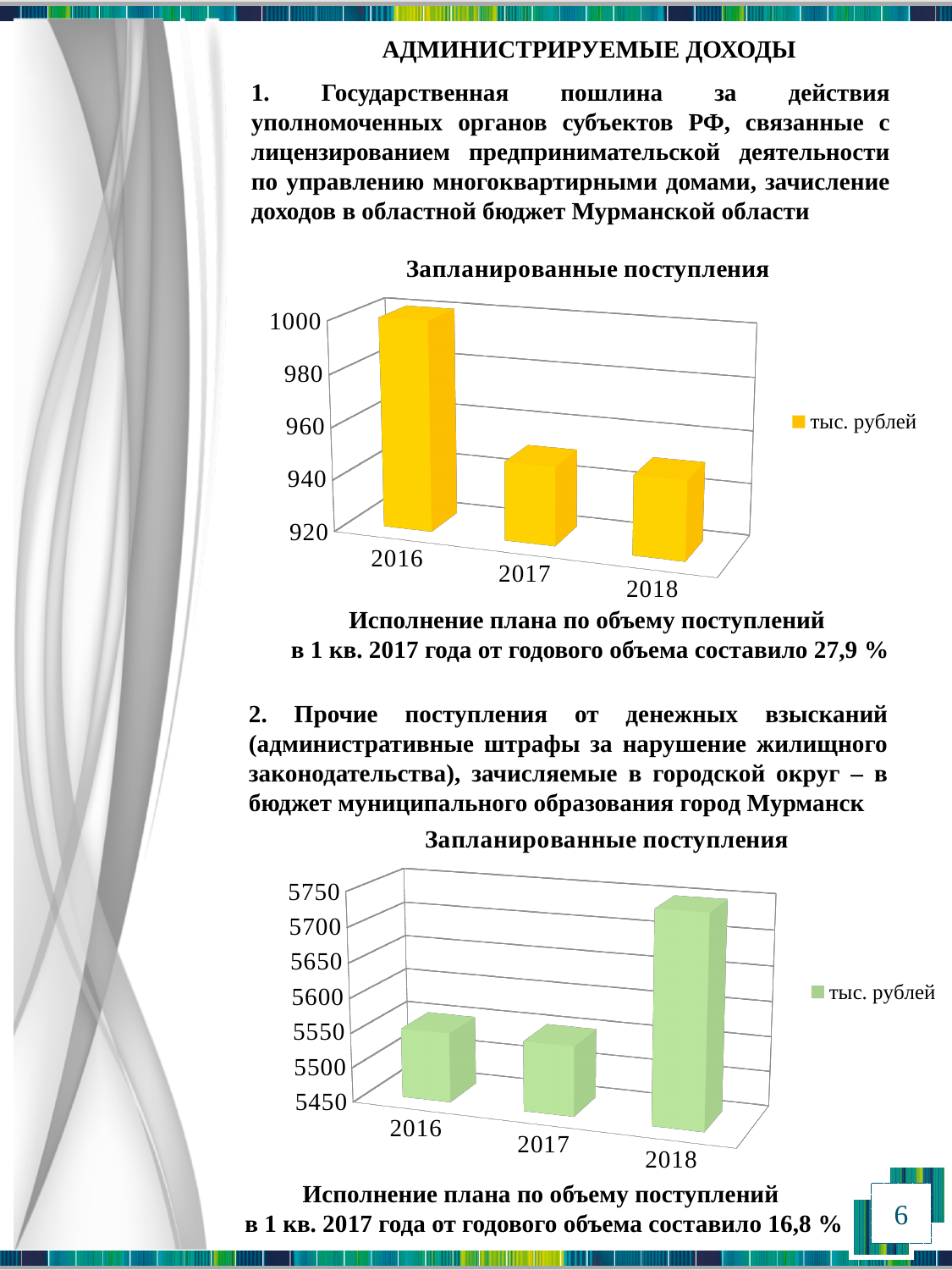
In the bottom chart, how many categories are plotted? 3 What is the legend entry of the bottom chart? тыс. рублей In the bottom chart, is the value for 2018 greater or less than 5650? greater In the top chart, how many years are shown on the x axis? 3 In the bottom chart, which year has the highest planned revenue? 2018 What kind of chart is the bottom chart on the slide? bar chart How many series does the legend of the top chart list? 1 In the top chart, is the value for 2017 greater or less than 960? less In the top chart, which year has the highest planned revenue? 2016 In the bottom chart, is the value for 2016 greater or less than 5600? less What kind of chart is the top chart on the slide? bar chart